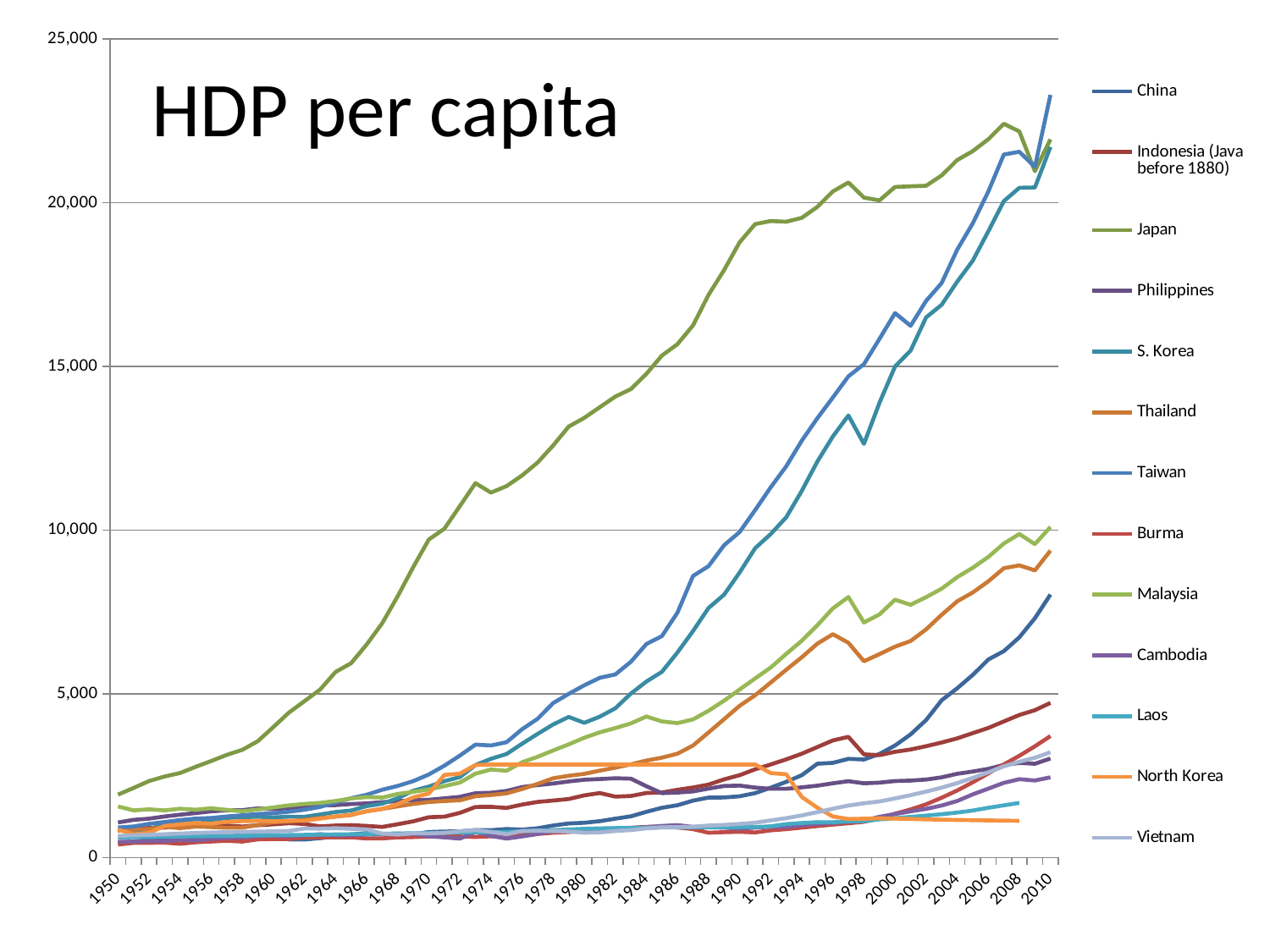
What is the title of the chart? HDP per capita Is the value for Taiwan in 2010 greater or less than 20,000? greater Does the value for Japan rise or fall from 1950 to 2010? rise Which series has the highest value in 1990? Japan Is the value for North Korea in 2008 greater or less than 5,000? less Which is larger in 1980, the value for Japan or the value for Taiwan? Japan How many series does the legend list? 13 Is the value for Japan in 1990 greater or less than 15,000? greater Which series has the highest value in 1970? Japan Which is larger in 2000, the value for Malaysia or the value for Thailand? Malaysia What kind of chart is shown on the slide? line chart